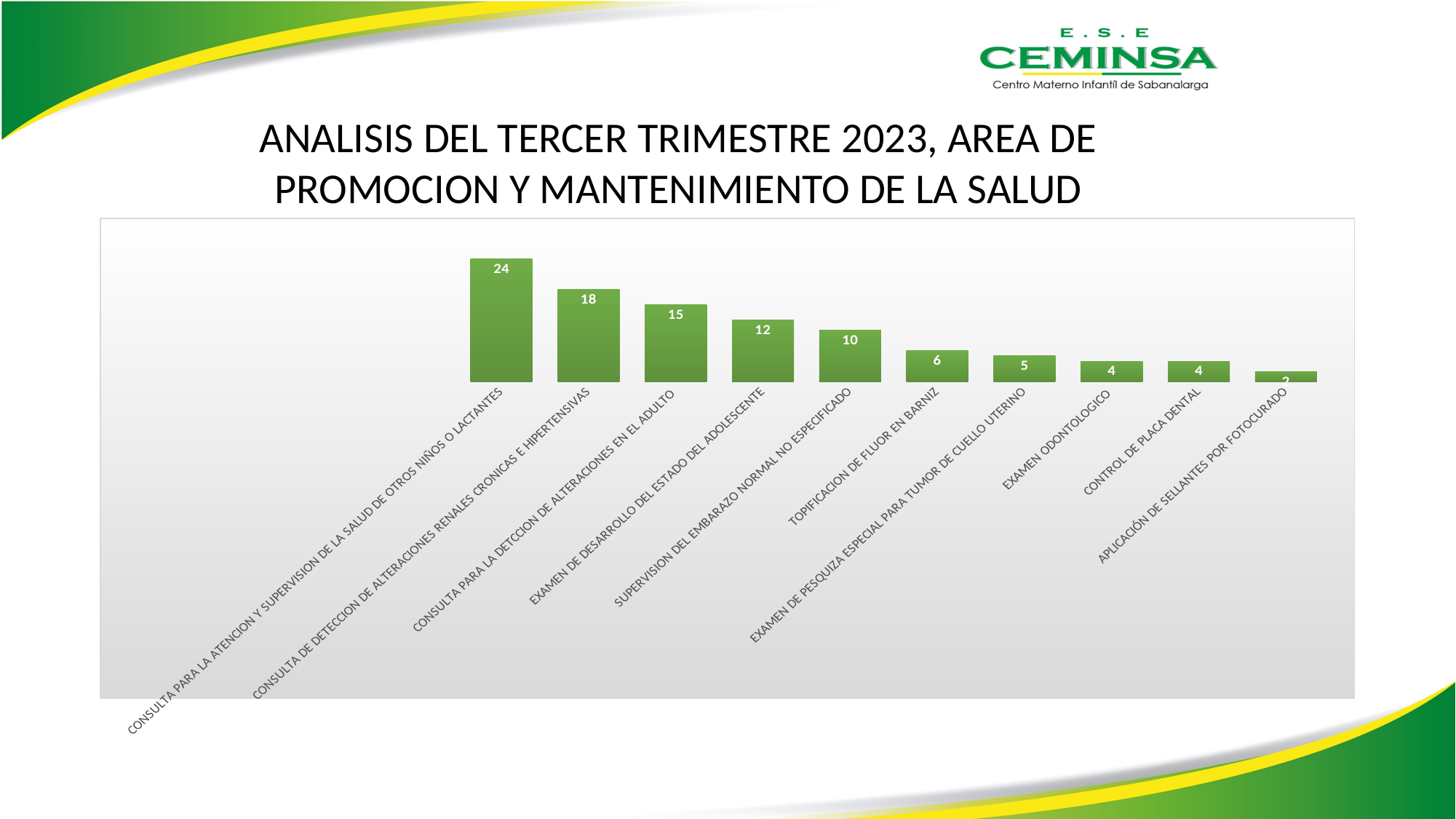
What colour are the bars in the chart? Green What is the value for EXAMEN DE DESARROLLO DEL ESTADO DEL ADOLESCENTE? 12 What is the difference between the values for CONSULTA DE DETECCION DE ALTERACIONES RENALES CRONICAS E HIPERTENSIVAS and CONSULTA PARA LA DETCCION DE ALTERACIONES EN EL ADULTO? 3 What is the value for CONSULTA PARA LA ATENCION Y SUPERVISION DE LA SALUD DE OTROS NIÑOS O LACTANTES? 24 Which is larger, the value for SUPERVISION DEL EMBARAZO NORMAL NO ESPECIFICADO or the value for EXAMEN DE PESQUIZA ESPECIAL PARA TUMOR DE CUELLO UTERINO? SUPERVISION DEL EMBARAZO NORMAL NO ESPECIFICADO What is the value for TOPIFICACION DE FLUOR EN BARNIZ? 6 Do the values rise or fall from left to right across the chart? Fall How many categories are shown in the chart? 10 Which category has the highest value? CONSULTA PARA LA ATENCION Y SUPERVISION DE LA SALUD DE OTROS NIÑOS O LACTANTES What is the value for CONTROL DE PLACA DENTAL? 4 What kind of chart is shown on the slide? Bar chart Which category has the lowest value? APLICACIÓN DE SELLANTES POR FOTOCURADO